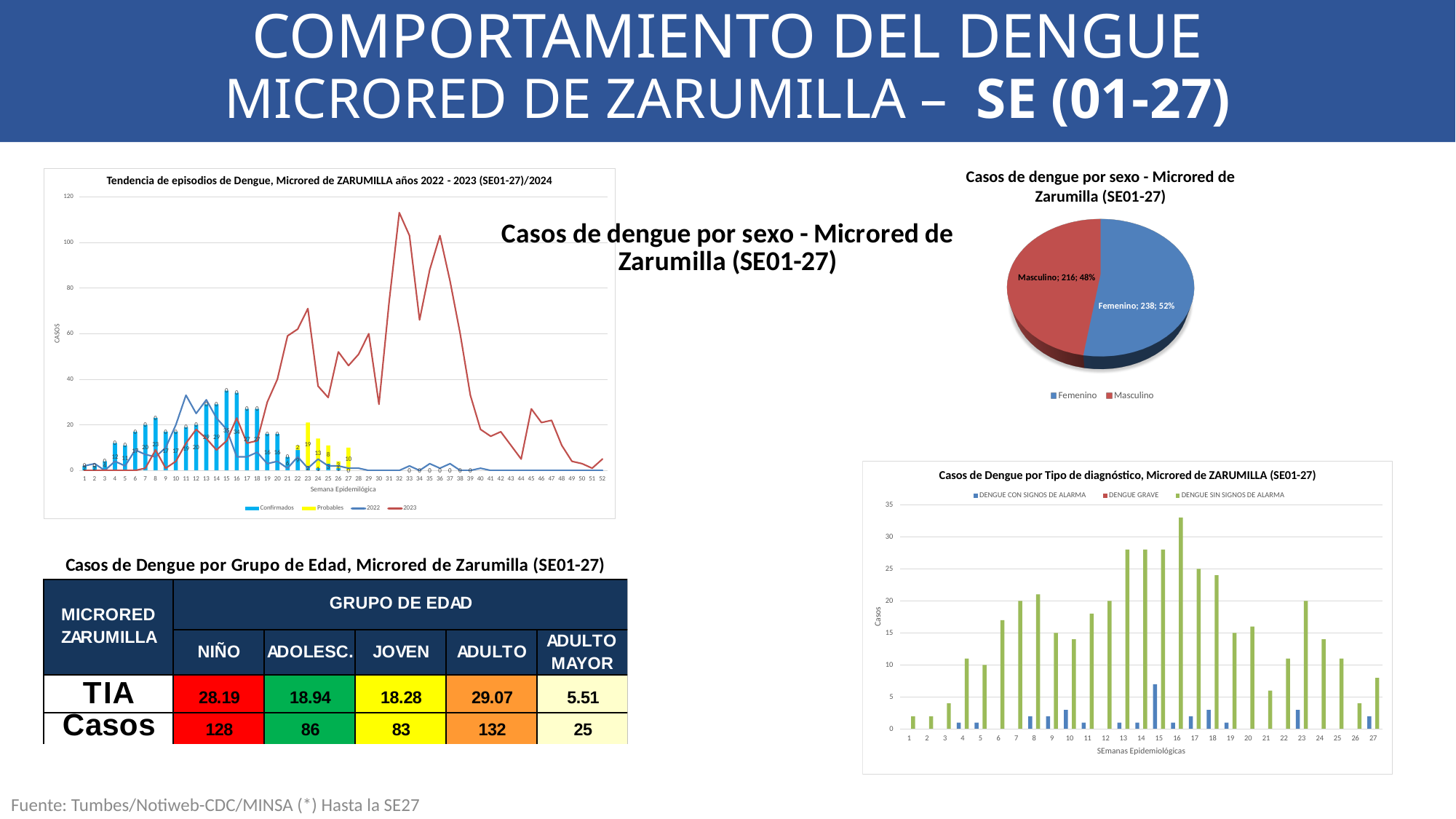
In the pie chart 'Casos de dengue por sexo', which sex has more cases? Femenino What kind of chart is 'Casos de dengue por sexo - Microred de Zarumilla (SE01-27)'? pie chart In the pie chart 'Casos de dengue por sexo', what share of cases is Femenino? 52% In the pie chart 'Casos de dengue por sexo', what is the difference between Femenino and Masculino cases? 22 In the chart 'Casos de Dengue por Tipo de diagnóstico', in which week is the DENGUE SIN SIGNOS DE ALARMA bar highest? 16 In the pie chart 'Casos de dengue por sexo', how many cases are Femenino? 238 How many series does the legend of the chart 'Tendencia de episodios de Dengue' list? 4 What kind of chart is 'Casos de Dengue por Tipo de diagnóstico, Microred de ZARUMILLA (SE01-27)'? bar chart In the pie chart 'Casos de dengue por sexo', how many cases are Masculino? 216 In the chart 'Casos de Dengue por Tipo de diagnóstico', is the DENGUE SIN SIGNOS DE ALARMA value for week 16 greater or less than 30? greater How many series does the legend of the chart 'Casos de Dengue por Tipo de diagnóstico' list? 3 How many epidemiological weeks are shown on the x axis of the chart 'Casos de Dengue por Tipo de diagnóstico'? 27